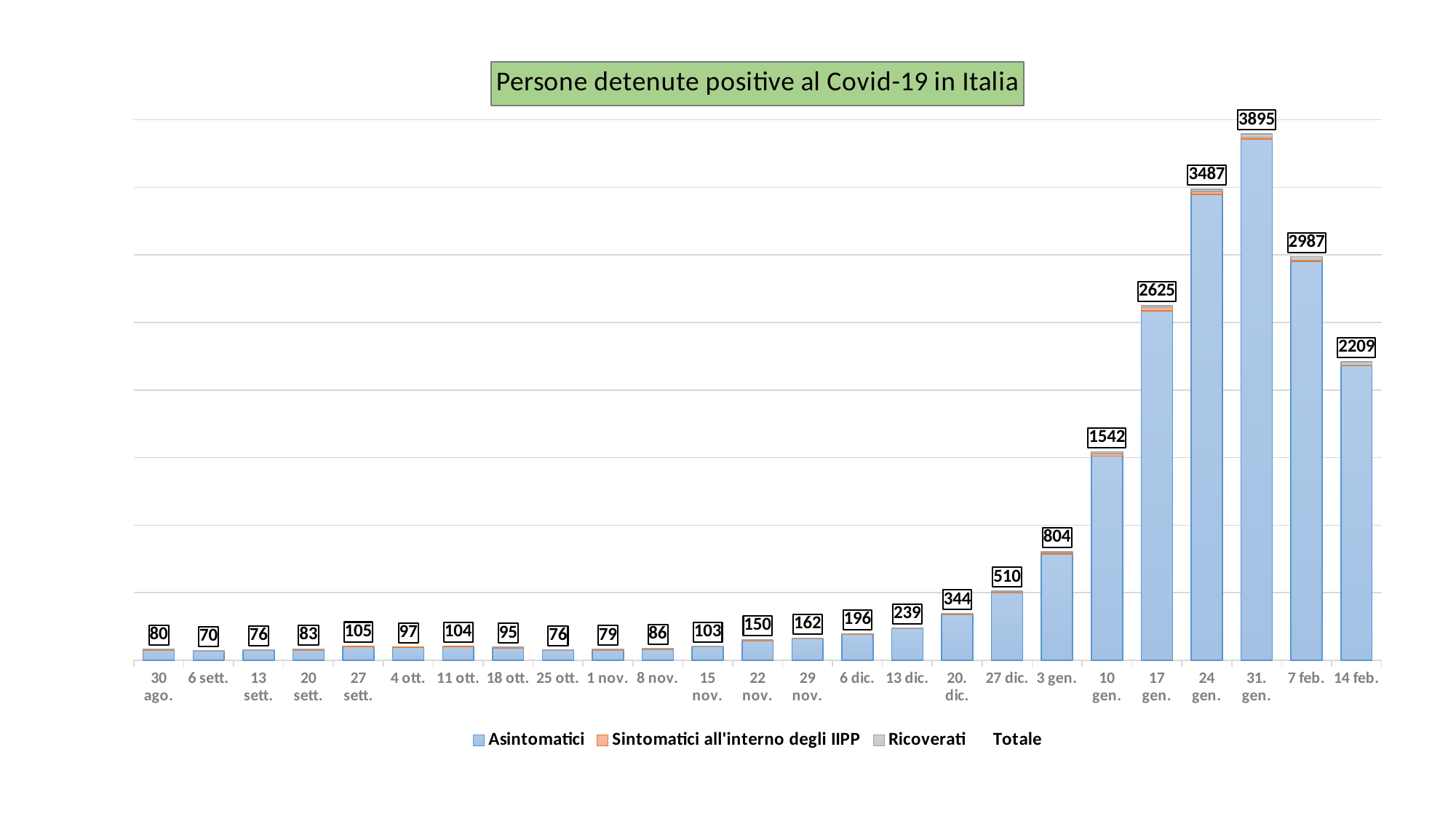
What is the total value shown for 14 feb.? 2209 How many dates are shown on the x axis? 25 What is the total value shown for 31 gen.? 3895 Which date has the lowest total? 6 sett. What is the title of the chart? Persone detenute positive al Covid-19 in Italia What kind of chart is this? Stacked bar chart How many entries does the legend list? 4 Which date has the highest total? 31 gen. Do the totals generally rise or fall from 8 nov. to 31 gen.? Rise What is the difference between the totals for 31 gen. and 24 gen.? 408 What is the total value shown for 30 ago.? 80 Which is larger, the total for 7 feb. or the total for 17 gen.? 7 feb.